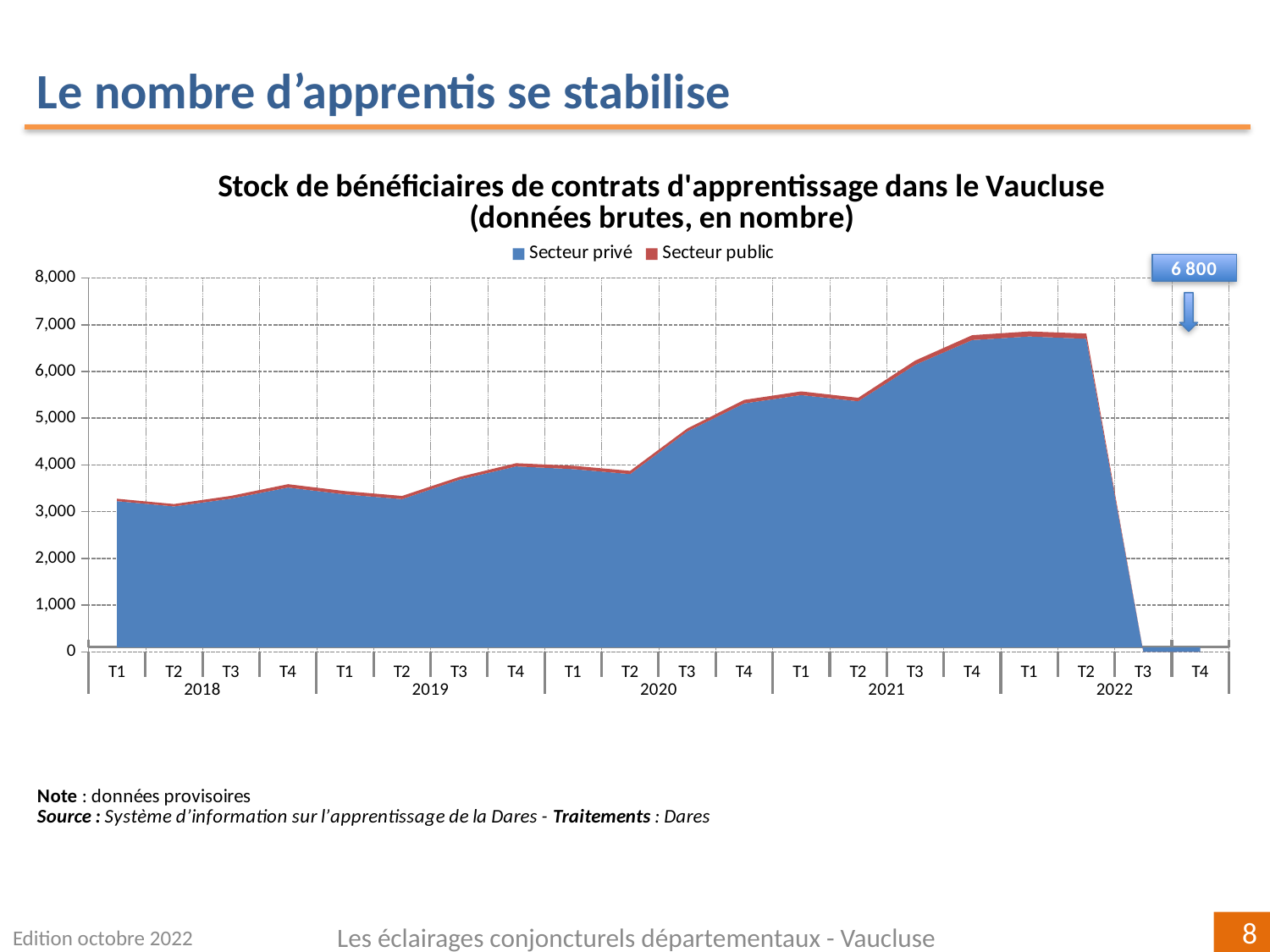
Is the total value for T1 2018 greater or less than 3,000? greater What kind of chart is shown on the slide? Area chart How many series does the legend list? 2 Is the total value for T2 2021 greater or less than 6,000? less Between T2 2020 and T4 2021, do the values rise or fall? rise What are the two series named in the legend? Secteur privé and Secteur public What value is shown in the callout box at the top right of the chart? 6 800 Which is larger, the total for T4 2021 or the total for T1 2018? T4 2021 Is the total value for T4 2021 greater or less than 6,000? greater Which series accounts for almost all of the stacked area, Secteur privé or Secteur public? Secteur privé How many quarters are labelled along the x axis? 20